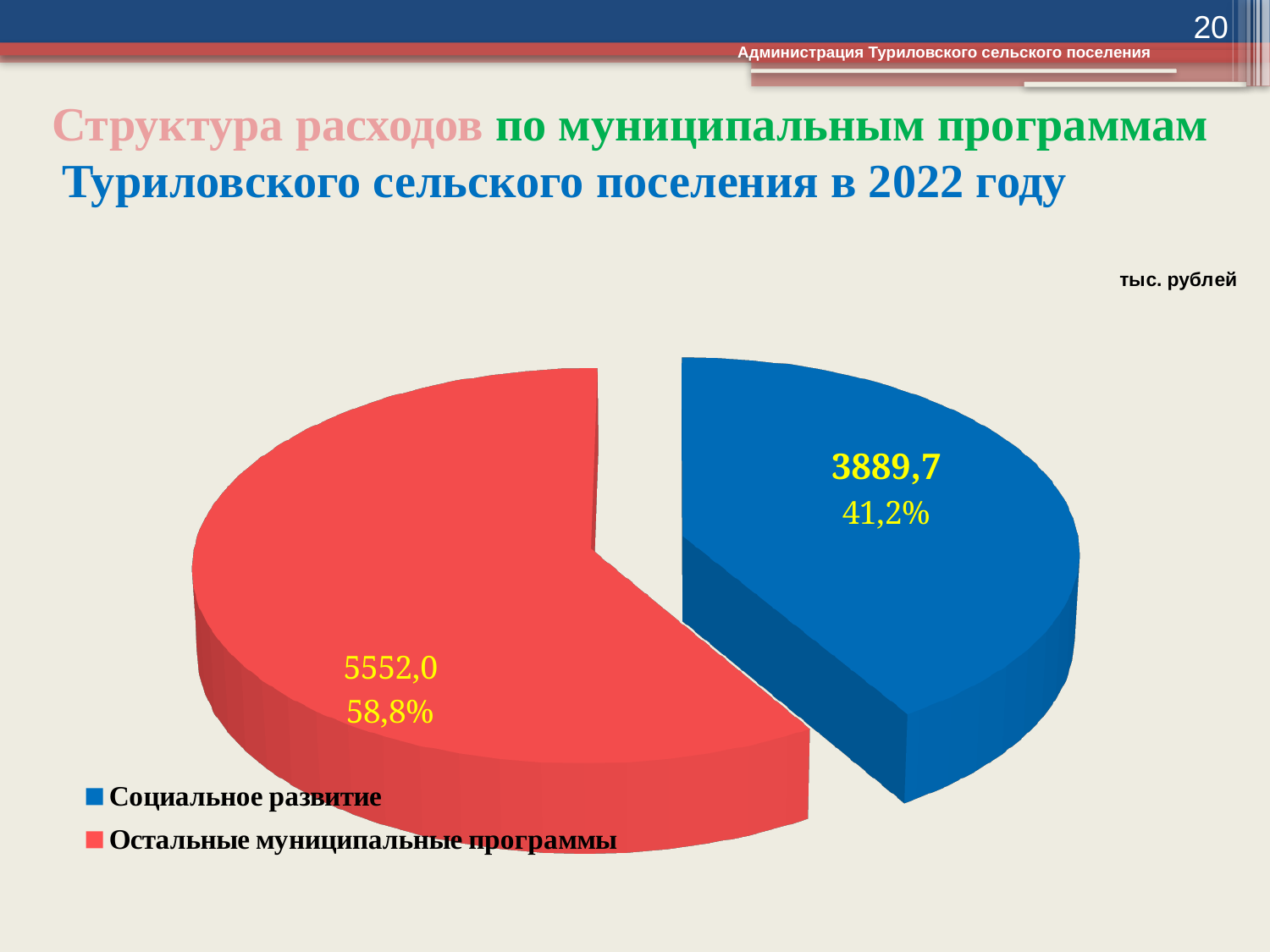
What kind of chart is shown on the slide? Pie chart What is the value for Остальные муниципальные программы? 5552,0 How many categories does the pie chart have? 2 What share of the pie does Остальные муниципальные программы represent? 58,8% Which category has the smallest slice? Социальное развитие What is the total of the two slices? 9441,7 What share of the pie does Социальное развитие represent? 41,2% What is the value for Социальное развитие? 3889,7 What is the difference between the values for Остальные муниципальные программы and Социальное развитие? 1662,3 Which category has the largest slice? Остальные муниципальные программы Which is larger: Социальное развитие or Остальные муниципальные программы? Остальные муниципальные программы What colour is the slice for Социальное развитие? Blue